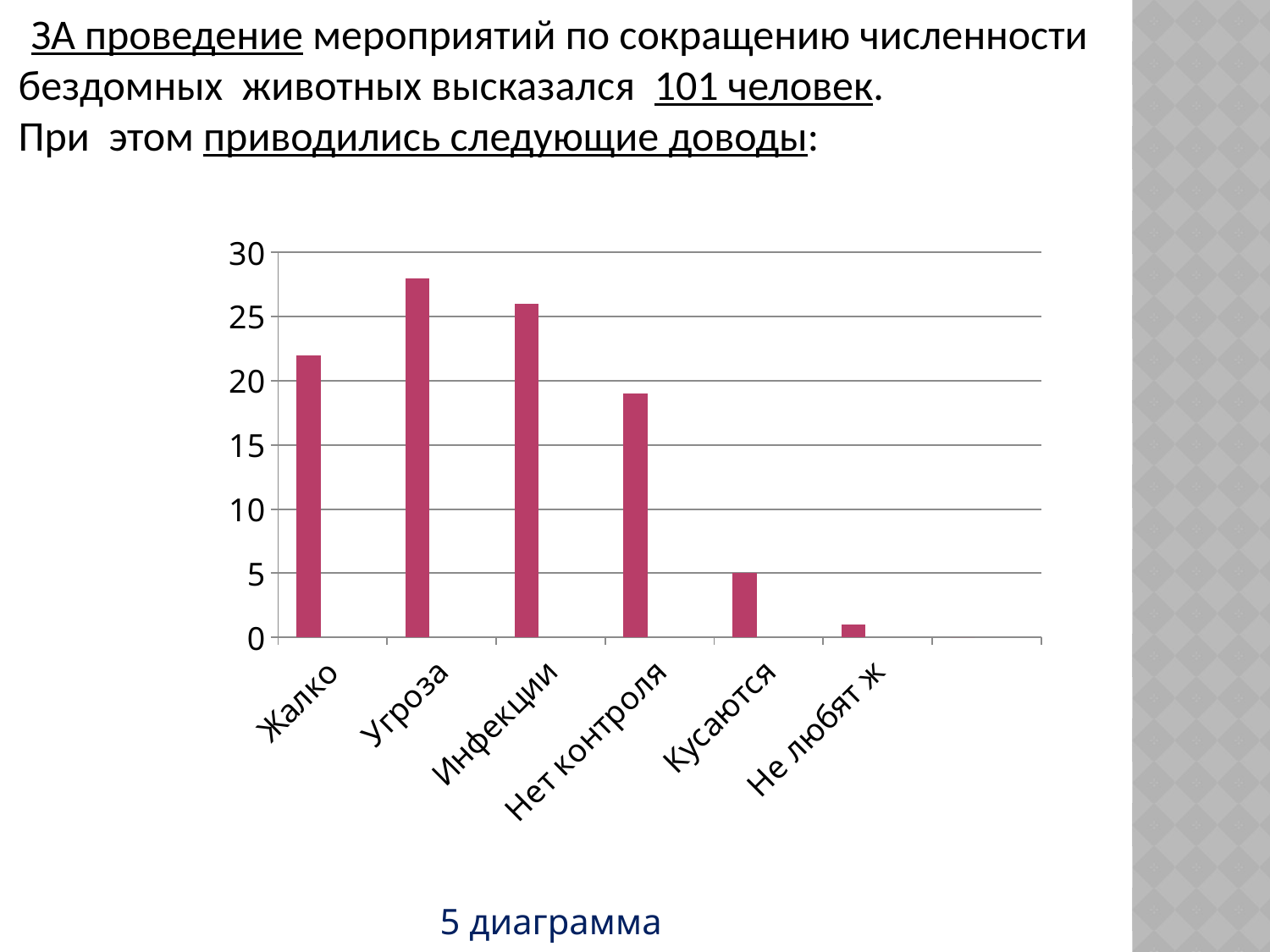
How many categories are shown on the x axis of the chart? 6 Is the value for Не любят ж greater or less than 5? less What kind of chart is shown on the slide? bar chart Which is larger, the value for Жалко or the value for Нет контроля? Жалко Is the value for Кусаются greater or less than 10? less Is the value for Жалко greater or less than 20? greater Which category has the highest bar in the chart? Угроза Which category has the lowest bar in the chart? Не любят ж What caption is written below the chart? 5 диаграмма Which is larger, the value for Инфекции or the value for Кусаются? Инфекции